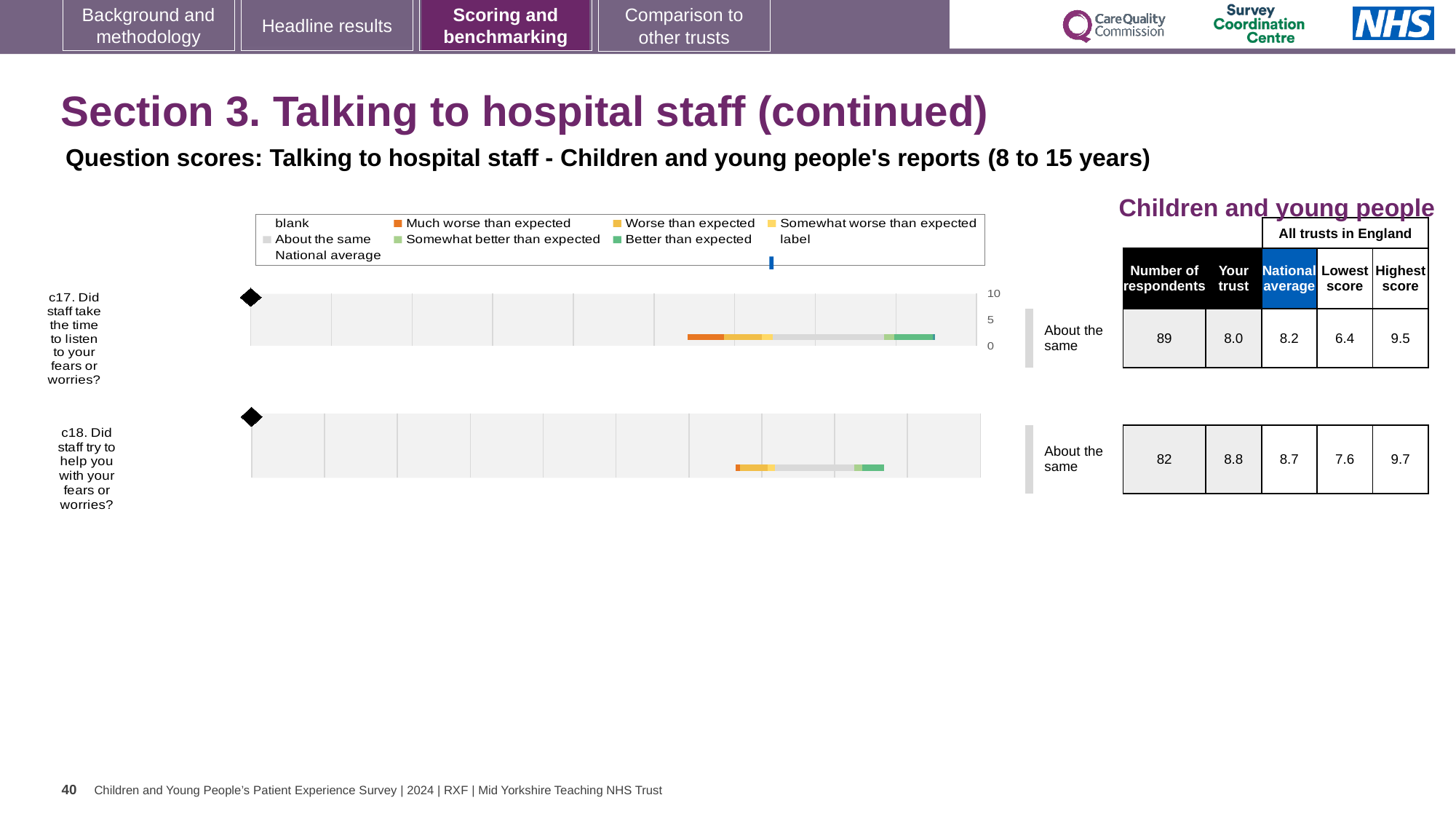
How many respondents answered question c17? 89 What kind of chart is used to show the benchmarking results for questions c17 and c18? bar chart What is the difference between the 'Your trust' scores for c18 and c17? 0.8 What is the 'Your trust' score for question c18 (Did staff try to help you with your fears or worries?)? 8.8 Which question has the higher 'Your trust' score, c17 or c18? c18 What is the national average score for question c17? 8.2 What is the 'Your trust' score for question c17 (Did staff take the time to listen to your fears or worries?)? 8.0 For question c17, which is larger: the 'Your trust' score or the national average? National average What is the difference between the highest score and the lowest score for question c17? 3.1 What is the highest score among all trusts in England for question c18? 9.7 What benchmarking category is shown next to the chart for question c18? About the same How many questions (c17, c18) are plotted on the slide's charts? 2